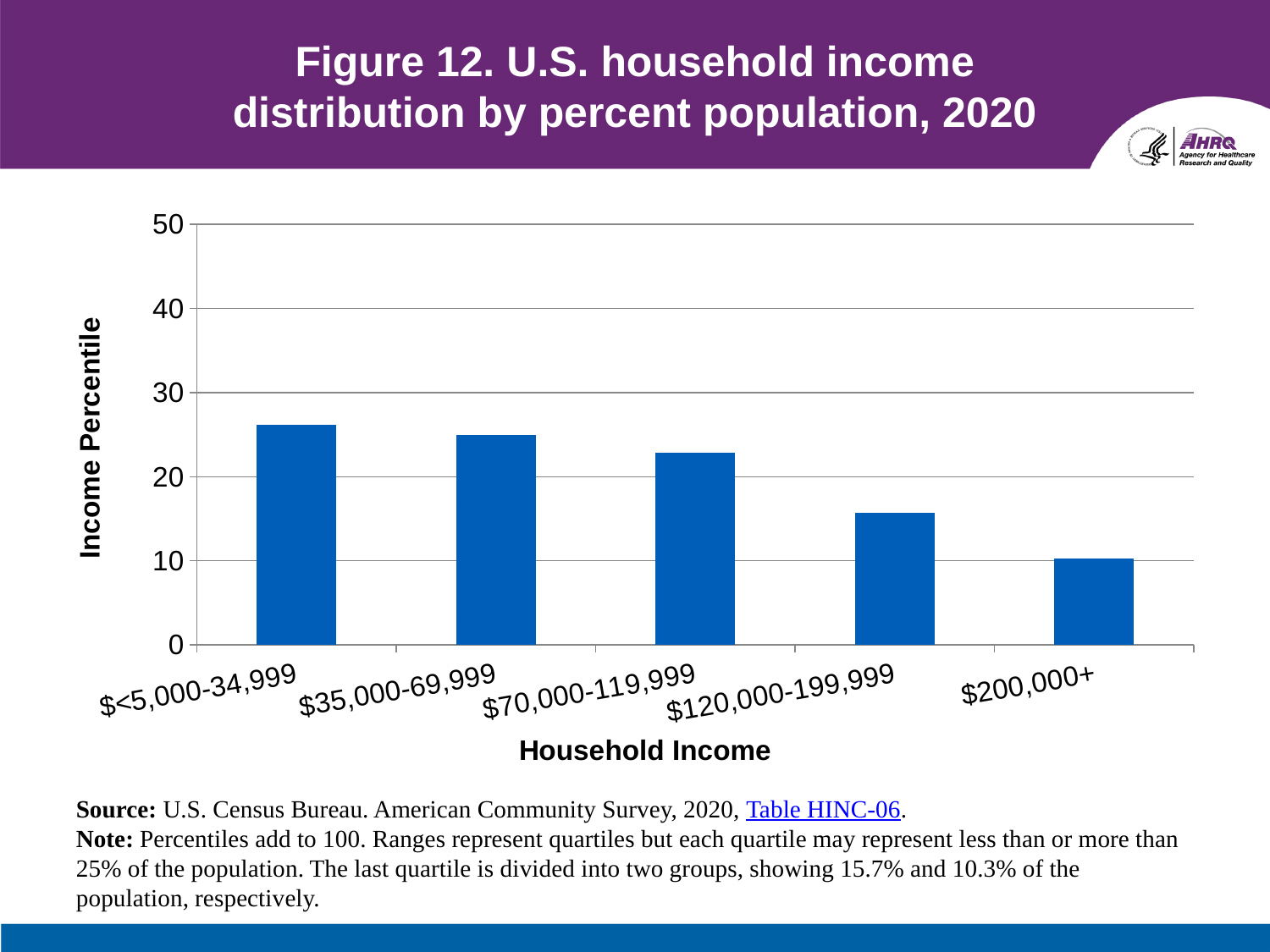
According to the note on the slide, what percent of the population does the $200,000+ group represent? 10.3% Which household income category has the lowest value? $200,000+ Is the value for $120,000-199,999 greater or less than 20? less What is the title of the y axis? Income Percentile Which is larger, the value for $70,000-119,999 or the value for $120,000-199,999? $70,000-119,999 According to the note on the slide, what percent of the population does the $120,000-199,999 group represent? 15.7% What kind of chart is shown on the slide? bar chart Do the values rise or fall moving from left to right along the x axis? fall Is the value for $70,000-119,999 greater or less than 20? greater Is the value for $35,000-69,999 greater or less than 30? less How many household income categories are shown on the x axis? 5